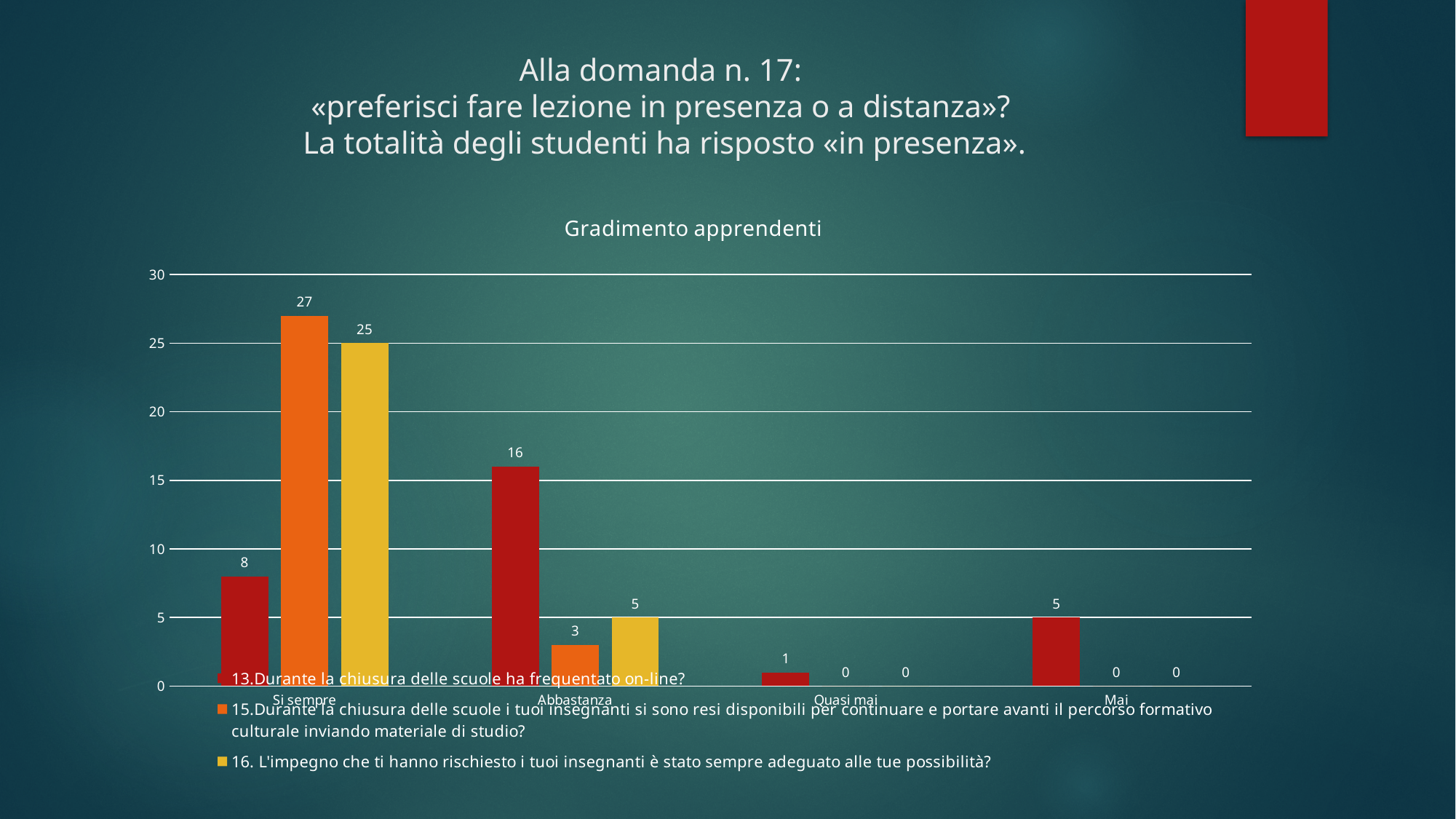
What is the difference between the 'Si sempre' values of series 15 and series 16? 2 What is the value for 'Si sempre' in series 15 (insegnanti disponibili inviando materiale di studio)? 27 What is the value for 'Mai' in series 13 (ha frequentato on-line)? 5 For 'Abbastanza', which is larger: series 13 (ha frequentato on-line) or series 16 (impegno adeguato)? series 13 (ha frequentato on-line) How many categories are shown on the x axis? 4 What is the title of the chart? Gradimento apprendenti Which category has the lowest value in series 13 (ha frequentato on-line)? Quasi mai Which category has the highest value in series 16 (impegno adeguato)? Si sempre What is the total of the three series for 'Si sempre'? 60 How many series does the legend list? 3 What type of chart is shown on the slide? bar chart What is the value for 'Abbastanza' in series 13 (ha frequentato on-line)? 16